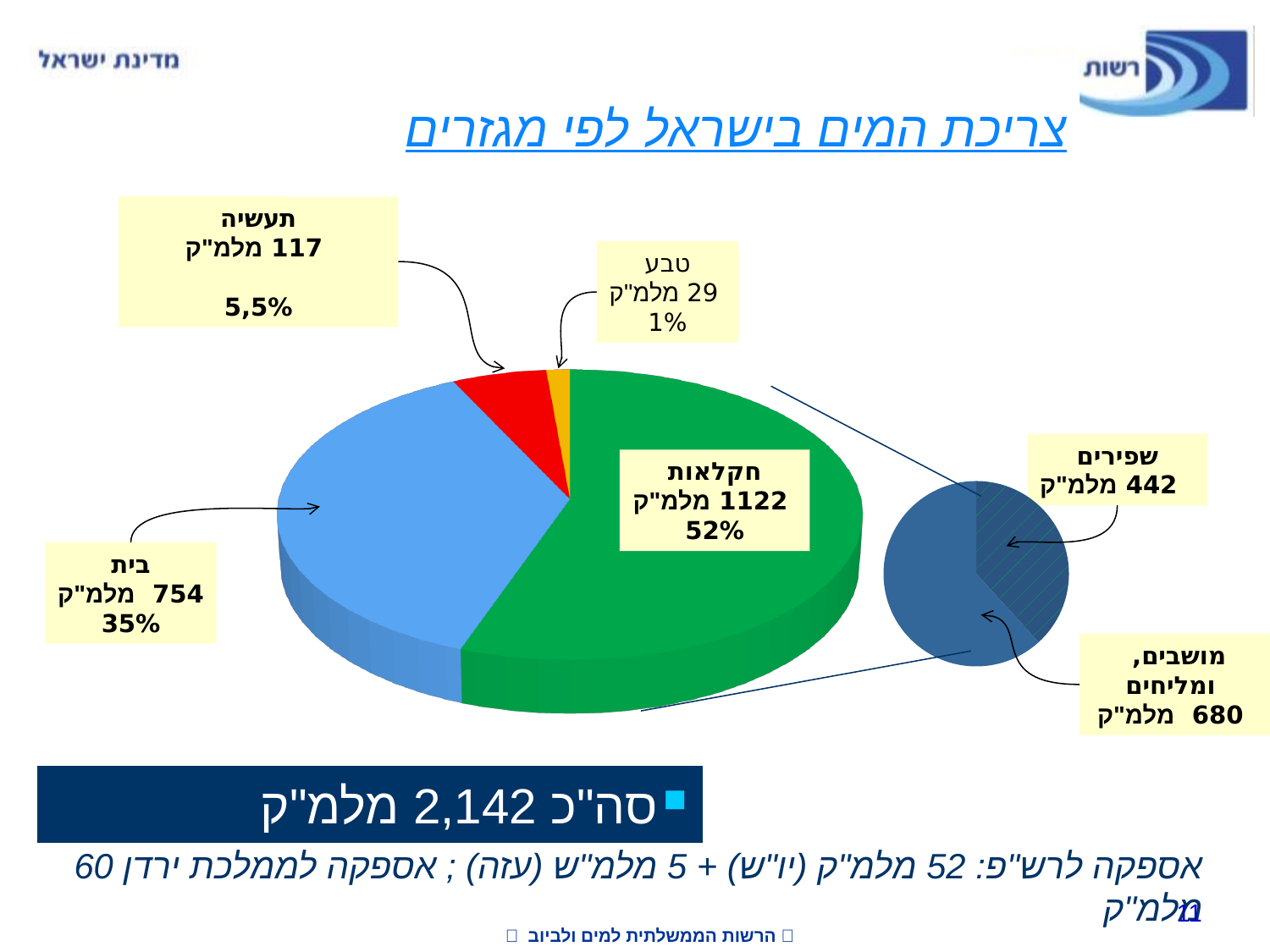
What is the difference in מלמ"ק between חקלאות and בית? 368 מלמ"ק In the breakdown of the agriculture slice, what is the value for שפירים? 442 מלמ"ק Which sector has the smallest slice in the pie chart? טבע What is the value shown for תעשיה (industry) in the pie chart? 117 מלמ"ק What is the water consumption value shown for חקלאות (agriculture) on the pie chart? 1122 מלמ"ק Which is larger, the value for בית or the value for תעשיה? בית What kind of chart is shown on the slide? Pie chart Which sector has the largest slice in the pie chart? חקלאות What percentage share does the בית (domestic) slice have in the pie chart? 35% How many slices does the main pie chart have? 4 What is the difference between מושבים ומליחים and שפירים in the agriculture breakdown? 238 מלמ"ק What percentage is shown for the טבע (nature) slice? 1%